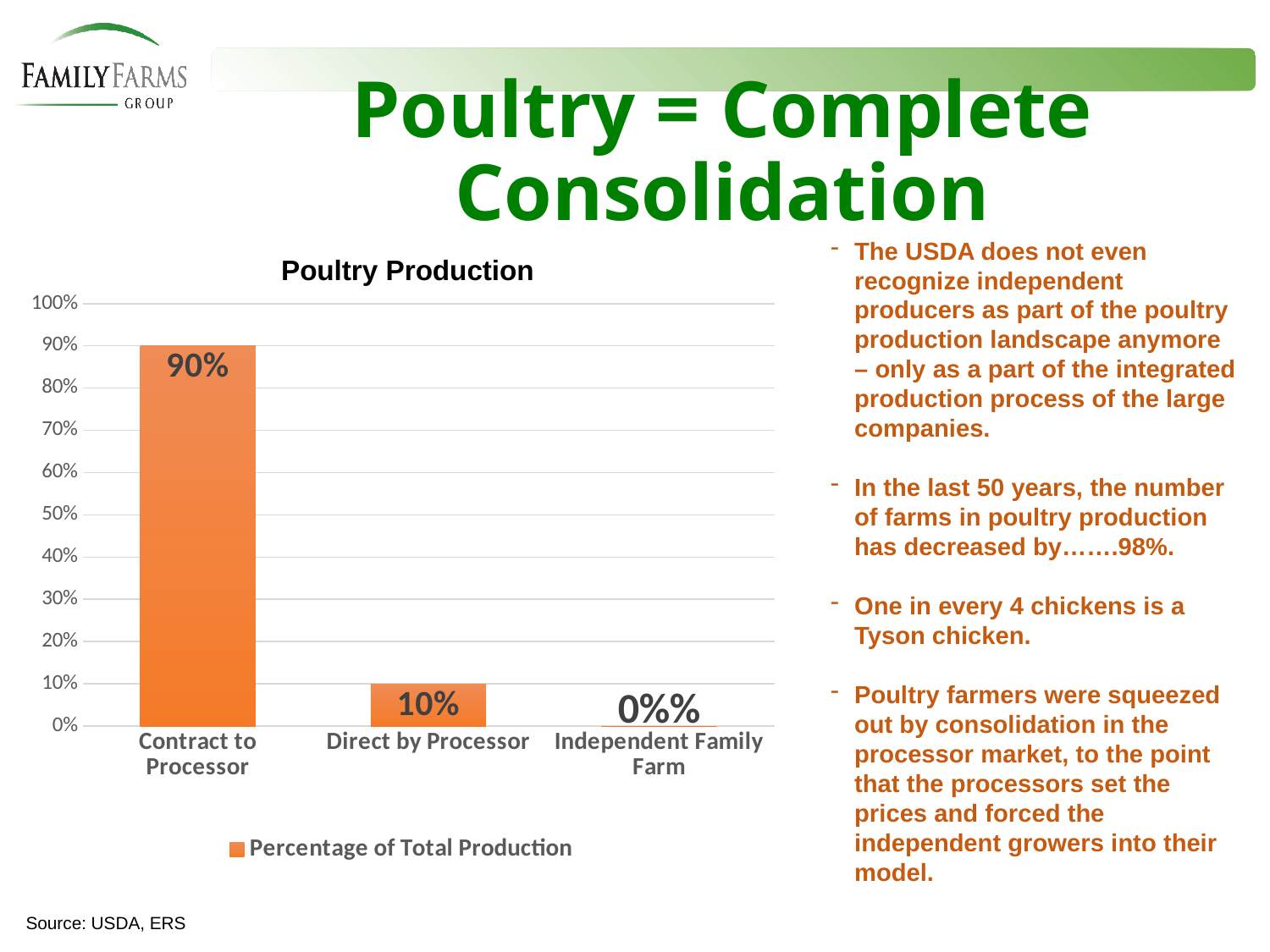
What is the value for Contract to Processor? 90% How many categories are shown on the x axis? 3 Which category has the highest value? Contract to Processor Which is larger, the value for Direct by Processor or the value for Independent Family Farm? Direct by Processor What series name is shown in the legend? Percentage of Total Production How many series does the legend list? 1 What is the title of the chart? Poultry Production Which category has the lowest value? Independent Family Farm Is the value for Contract to Processor greater or less than 50%? greater What is the difference between the values for Contract to Processor and Direct by Processor? 80% What type of chart is shown on the slide? bar chart What is the value for Direct by Processor? 10%